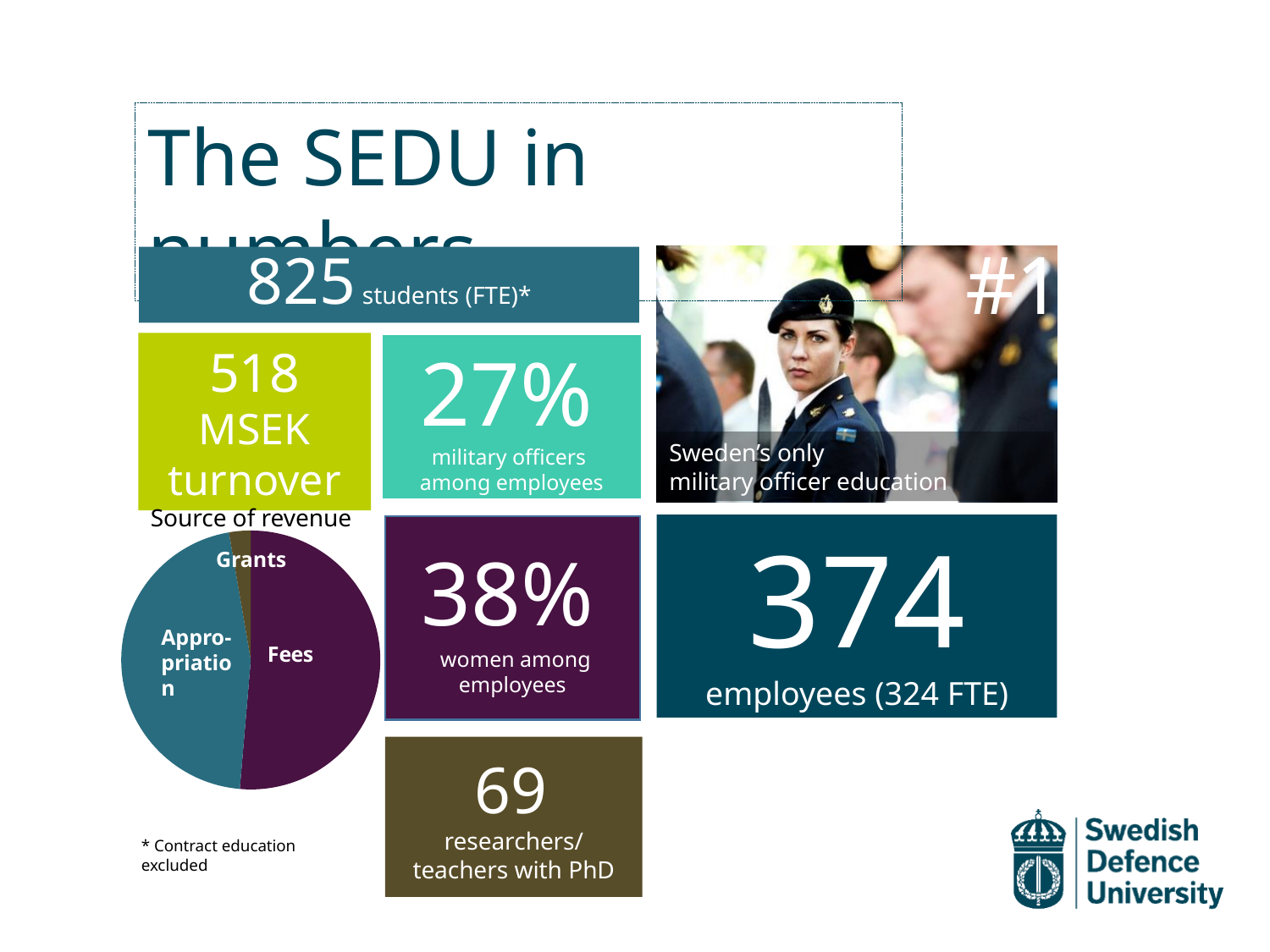
What kind of chart is the "Source of revenue" chart? pie chart In the "Source of revenue" pie chart, which is larger: Fees or Grants? Fees Which slice of the "Source of revenue" pie chart is the smallest? Grants How many slices does the "Source of revenue" pie chart have? 3 In the "Source of revenue" pie chart, which is larger: Appropriation or Grants? Appropriation What is the title of the pie chart on the slide? Source of revenue What are the three categories labelled in the "Source of revenue" pie chart? Appropriation, Fees, Grants